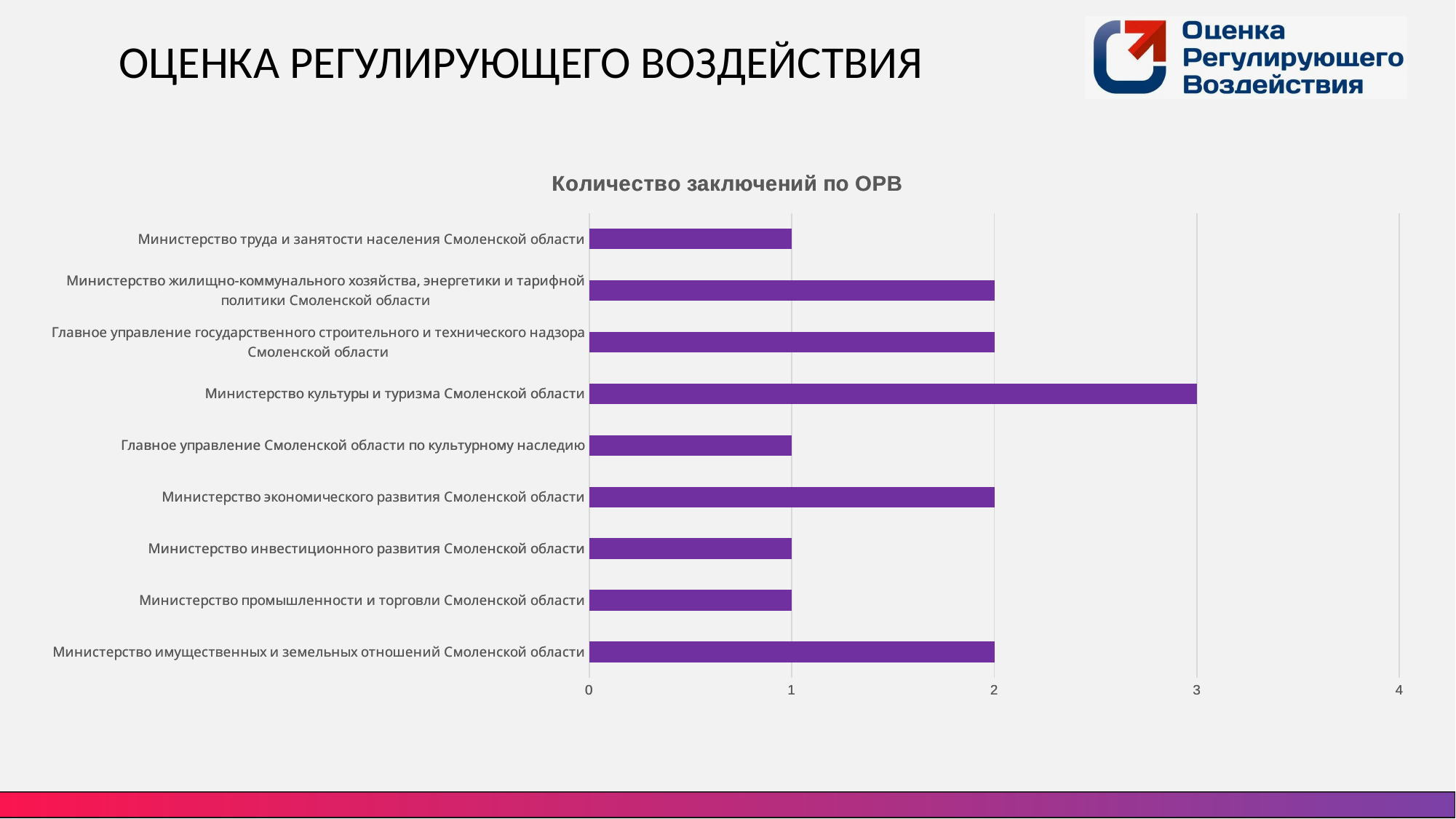
What is the maximum value shown on the horizontal axis? 4 Which organisation has the highest number of заключений по ОРВ? Министерство культуры и туризма Смоленской области Which is larger: the value for Министерство жилищно-коммунального хозяйства, энергетики и тарифной политики Смоленской области or the value for Министерство инвестиционного развития Смоленской области? Министерство жилищно-коммунального хозяйства, энергетики и тарифной политики Смоленской области How many categories (organisations) are shown in the chart? 9 What is the value for Министерство труда и занятости населения Смоленской области? 1 Is the value for Министерство культуры и туризма Смоленской области greater or less than 2? greater What is the value for Министерство экономического развития Смоленской области? 2 What is the value for Министерство культуры и туризма Смоленской области? 3 What is the title of the chart? Количество заключений по ОРВ What is the difference between the values for Министерство культуры и туризма Смоленской области and Министерство промышленности и торговли Смоленской области? 2 What type of chart is shown on the slide? bar chart What is the value for Министерство имущественных и земельных отношений Смоленской области? 2